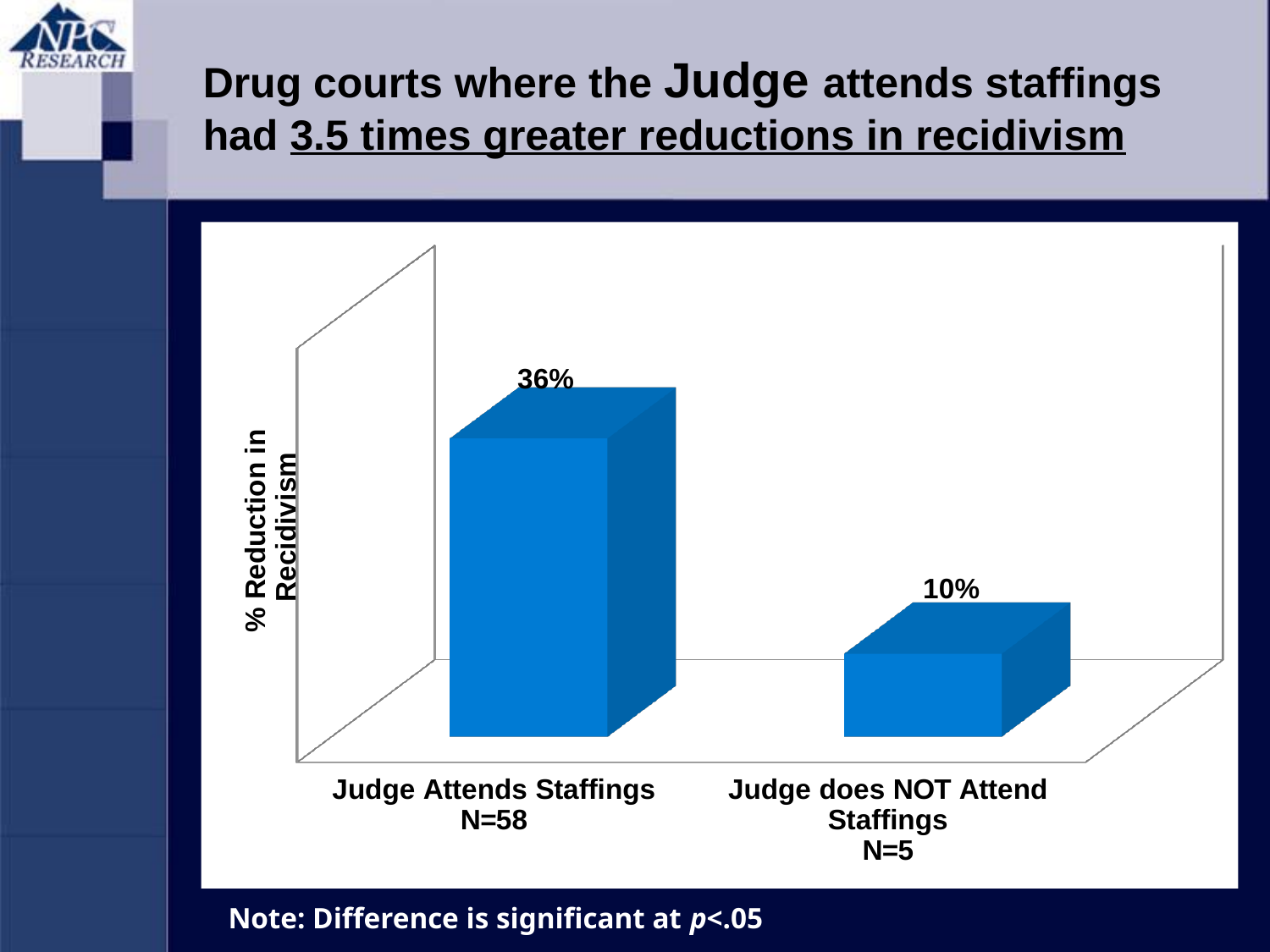
What is the % reduction in recidivism for drug courts where the judge attends staffings? 36% Which has a larger % reduction in recidivism: Judge Attends Staffings or Judge does NOT Attend Staffings? Judge Attends Staffings What kind of chart is shown on the slide? Bar chart What is the sample size (N) for the Judge Attends Staffings category? N=58 How many categories are shown in the chart? 2 What is the % reduction in recidivism for drug courts where the judge does NOT attend staffings? 10% What is the label on the vertical axis of the chart? % Reduction in Recidivism Which category shows the lowest % reduction in recidivism? Judge does NOT Attend Staffings What is the difference in % reduction in recidivism between courts where the judge attends staffings and those where the judge does not? 26% Which category shows the highest % reduction in recidivism? Judge Attends Staffings